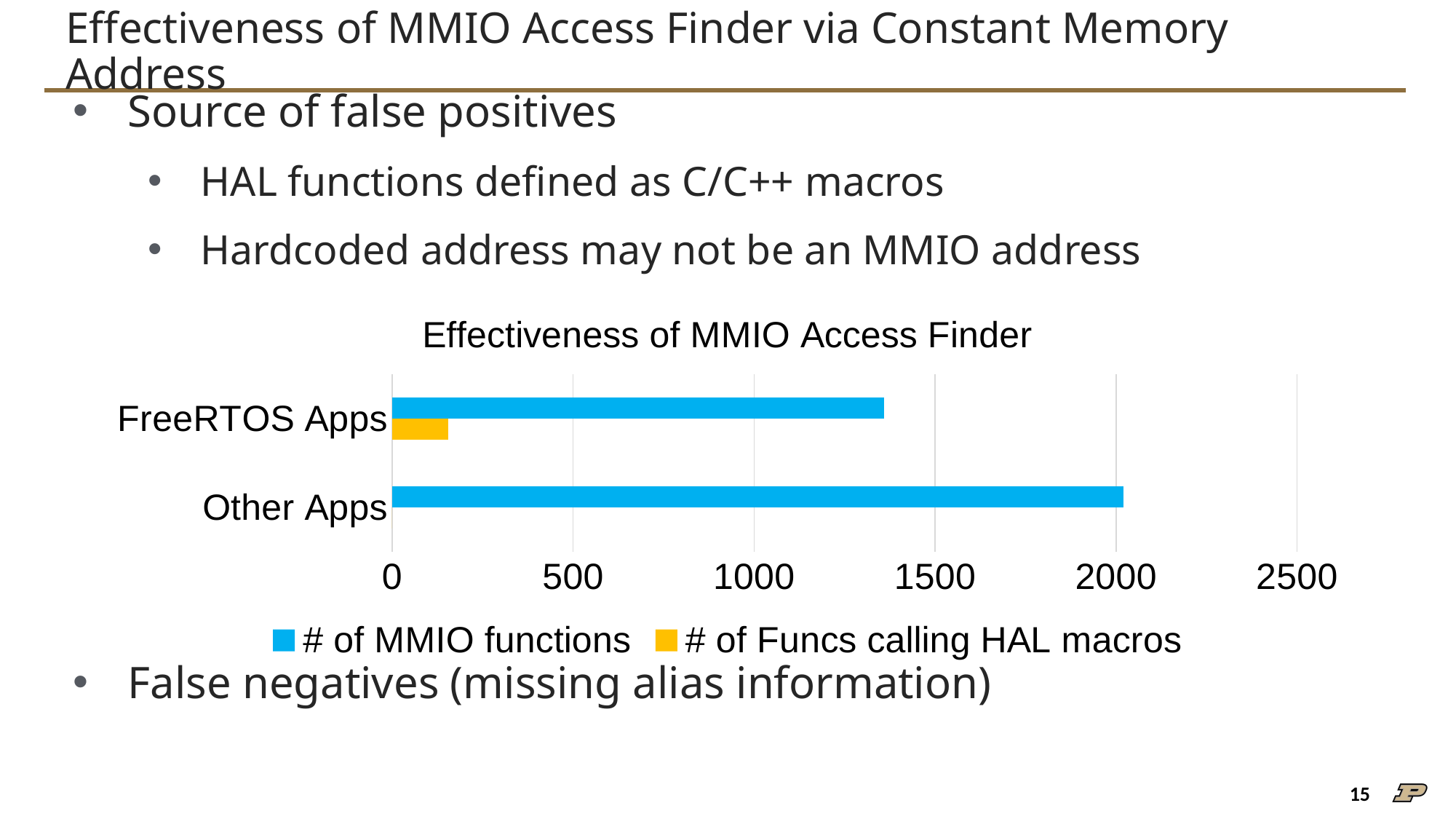
What is the largest value shown on the chart's horizontal axis? 2500 What is the title of the chart? Effectiveness of MMIO Access Finder Which series is drawn in yellow in the chart? # of Funcs calling HAL macros Is the value for # of MMIO functions for Other Apps greater or less than 1500? greater How many categories are shown on the chart's vertical axis? 2 Which category has the higher value for # of MMIO functions? Other Apps For FreeRTOS Apps, which is larger: # of MMIO functions or # of Funcs calling HAL macros? # of MMIO functions Is the value for # of MMIO functions for FreeRTOS Apps greater or less than 1500? less How many series does the chart legend list? 2 Is the value for # of MMIO functions for FreeRTOS Apps greater or less than 1000? greater What kind of chart is shown on the slide? bar chart